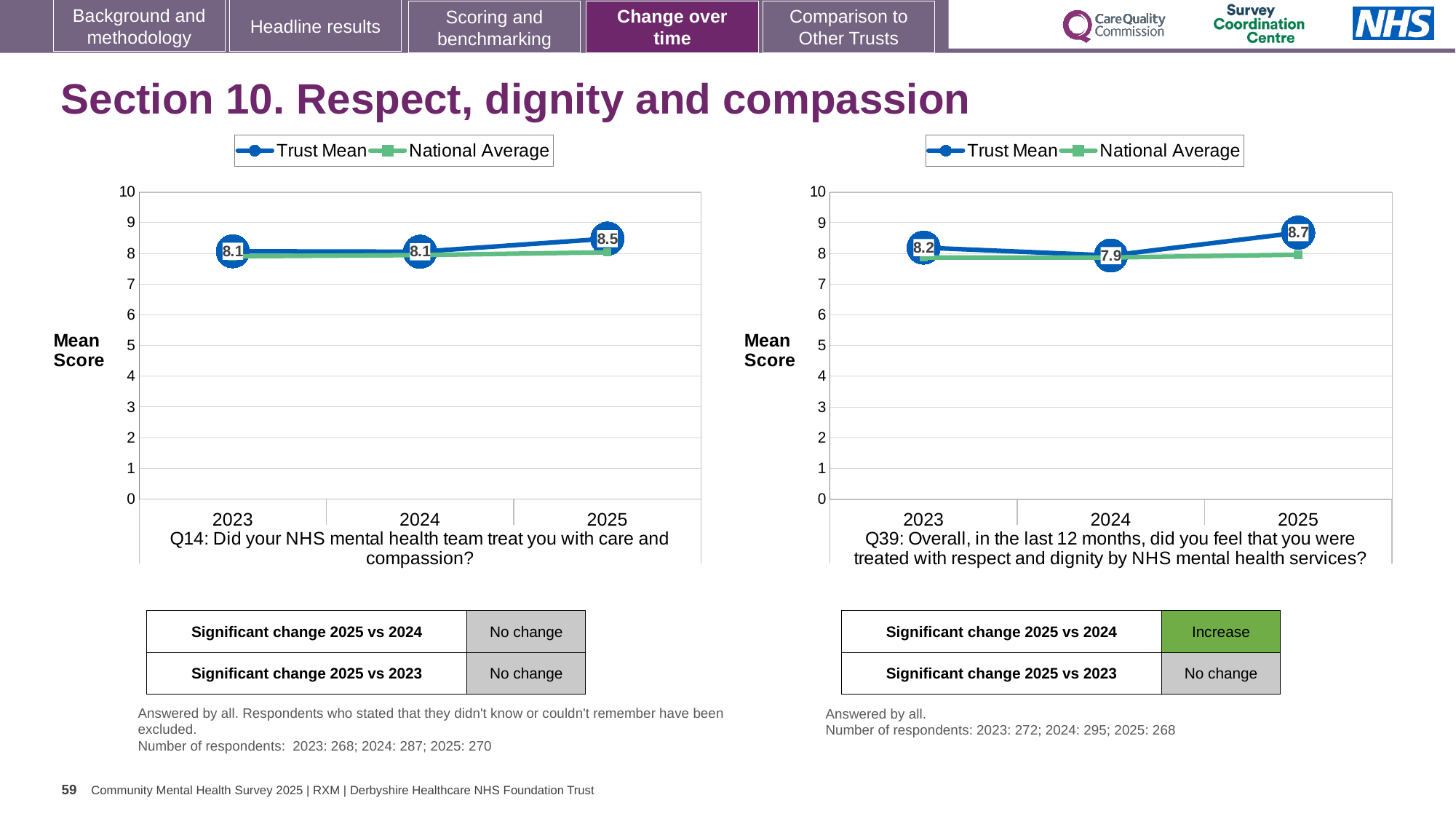
In the Q39 chart (right), what is the Trust Mean for 2024? 7.9 In the Q39 chart (right), which year has the lowest Trust Mean? 2024 How many years are shown on the x axis of the Q14 chart (left)? 3 How many series does the legend of the Q39 chart (right) list? 2 What kind of chart is the Q14 chart (left)? Line chart In the Q39 chart (right), which year has the highest Trust Mean? 2025 In the Q39 chart (right), what is the Trust Mean for 2025? 8.7 In the Q14 chart (left), what is the Trust Mean for 2025? 8.5 In the Q14 chart (left), what is the Trust Mean for 2023? 8.1 In the Q39 chart (right), what is the difference between the Trust Mean in 2025 and in 2024? 0.8 In the Q14 chart (left), is the National Average for 2023 greater or less than 9? less In the Q14 chart (left), is the Trust Mean higher in 2025 or in 2024? 2025